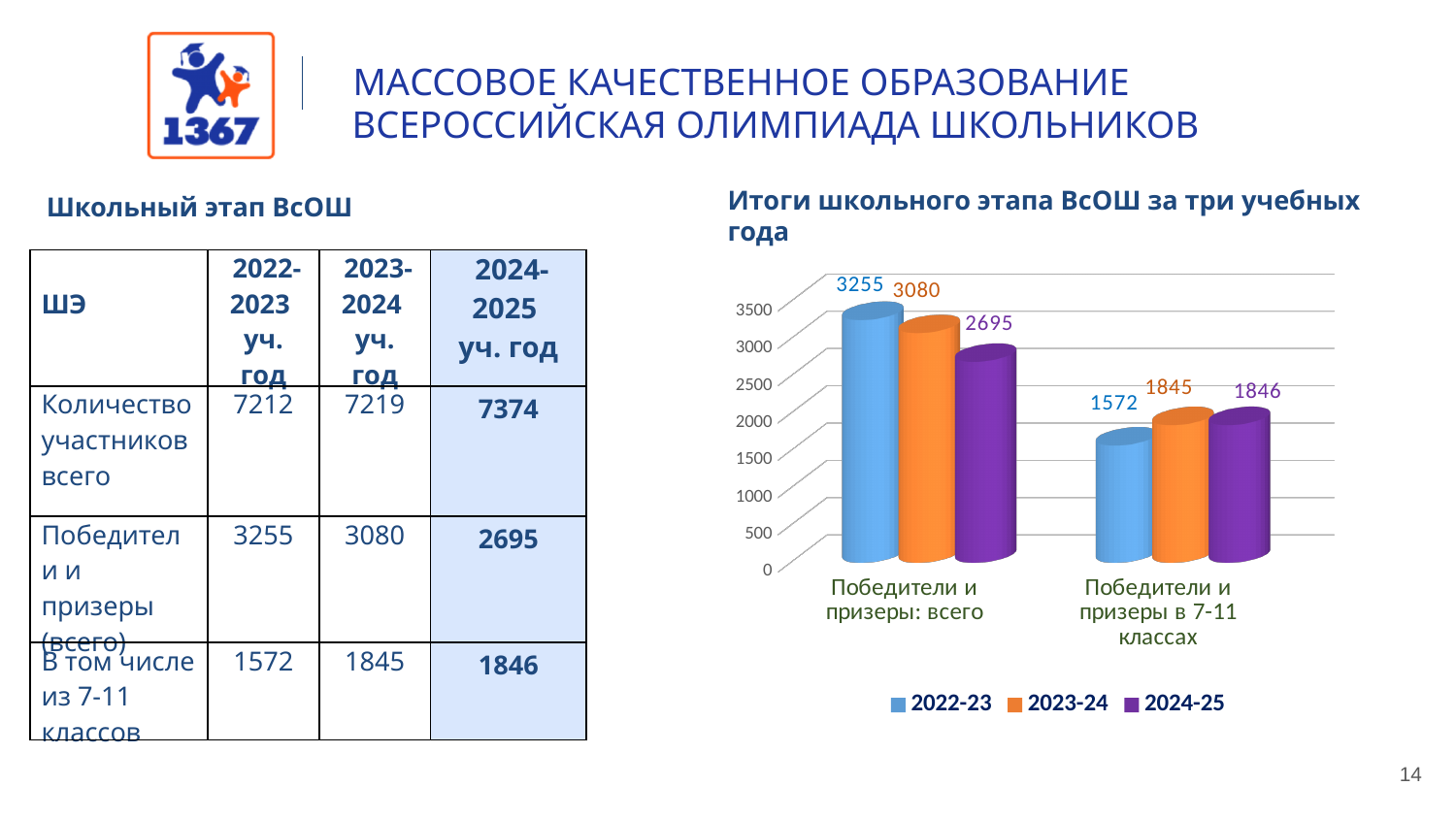
What is the difference between the 2022-23 and 2024-25 values in the category "Победители и призеры: всего"? 560 Which is larger: the 2023-24 value for "Победители и призеры: всего" or the 2023-24 value for "Победители и призеры в 7-11 классах"? Победители и призеры: всего How many series does the legend list? 3 Which series has the lowest value in the category "Победители и призеры в 7-11 классах"? 2022-23 What is the value for 2023-24 in the category "Победители и призеры в 7-11 классах"? 1845 What is the value for 2022-23 in the category "Победители и призеры в 7-11 классах"? 1572 What is the value for 2024-25 in the category "Победители и призеры: всего"? 2695 What type of chart is shown on the slide? bar chart What is the title of the chart? Итоги школьного этапа ВсОШ за три учебных года What is the value for 2022-23 in the category "Победители и призеры: всего"? 3255 Which series has the highest value in the category "Победители и призеры: всего"? 2022-23 What is the difference between the 2023-24 and 2022-23 values in the category "Победители и призеры в 7-11 классах"? 273